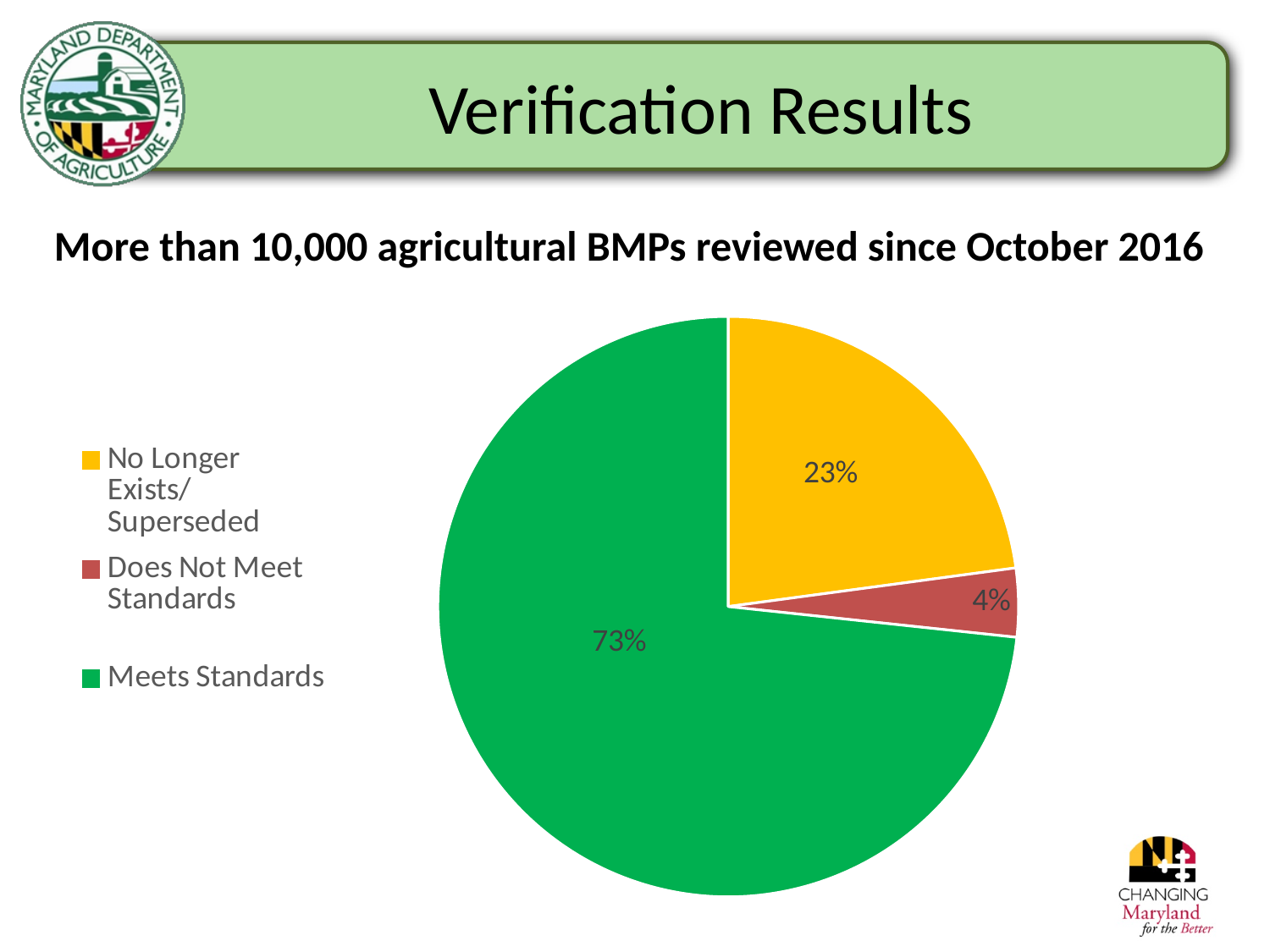
Which category has the smallest share of the pie? Does Not Meet Standards What is the title of the slide containing the pie chart? Verification Results What percentage of BMPs Does Not Meet Standards? 4% How many categories does the pie chart show? 3 What is the difference in percentage points between Meets Standards and No Longer Exists/Superseded? 50 Which category has the largest share of the pie? Meets Standards What colour represents Meets Standards in the pie chart? green What percentage of BMPs Meets Standards? 73% What kind of chart is shown on the slide? pie chart What percentage of BMPs falls under No Longer Exists/Superseded? 23% How many entries does the legend list? 3 Which is larger: the share for No Longer Exists/Superseded or the share for Does Not Meet Standards? No Longer Exists/Superseded